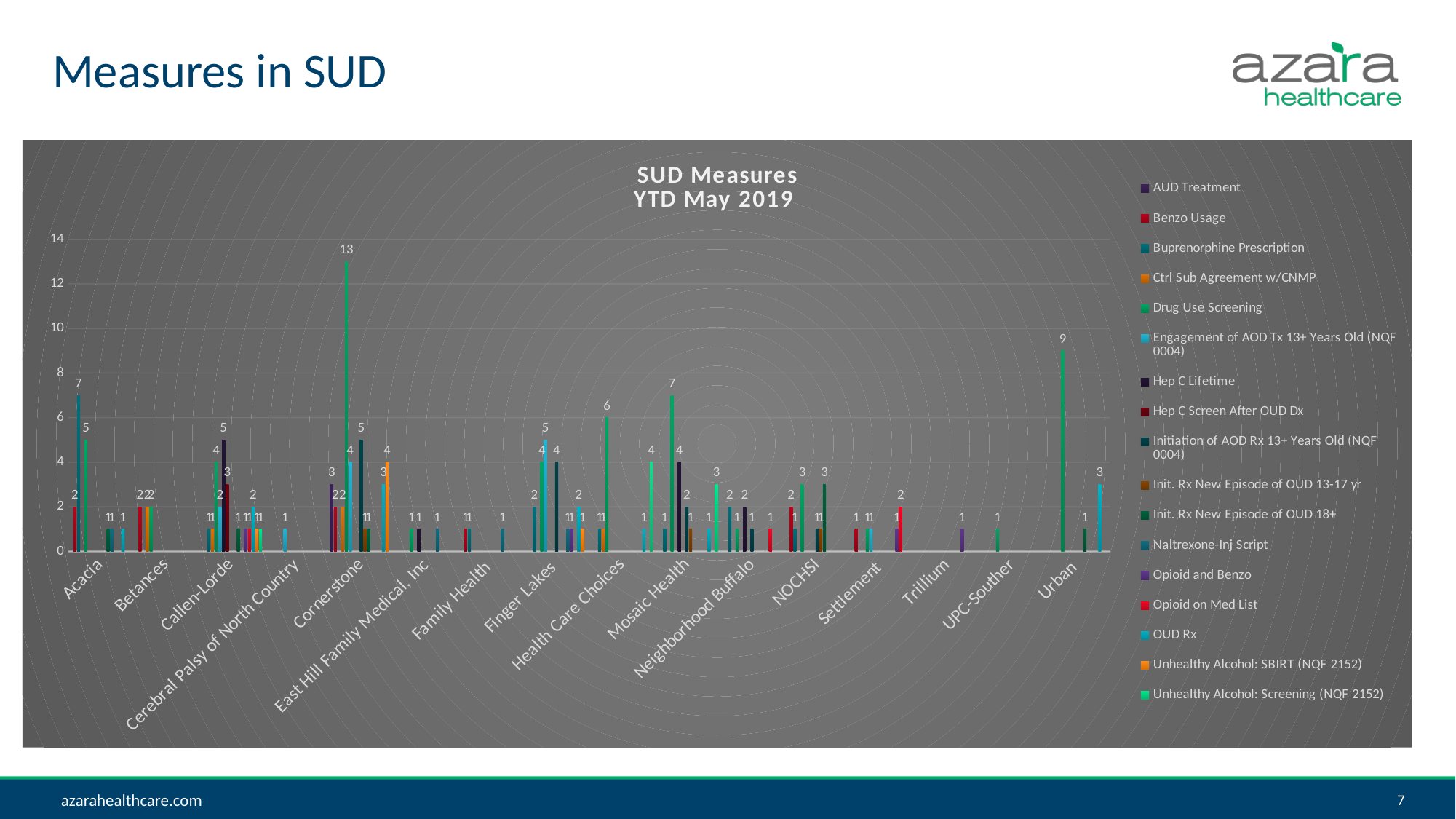
Is the tallest bar at Cornerstone greater or less than 10? greater What is the difference between the tallest bar at Cornerstone and the tallest bar at Urban? 4 What kind of chart is shown on the slide? bar chart How many series does the chart's legend list? 17 Which is larger: the tallest bar at Mosaic Health or the tallest bar at Urban? Urban Which organization has the tallest bar on the chart? Cornerstone What is the value of the tallest bar in the Urban group? 9 What is the highest value labeled anywhere on the chart? 13 What is the value of the tallest bar in the Acacia group? 7 How many organizations (categories) are listed along the x axis of the chart? 16 What is the value of the tallest bar in the Health Care Choices group? 6 What is the title of the chart? SUD Measures YTD May 2019